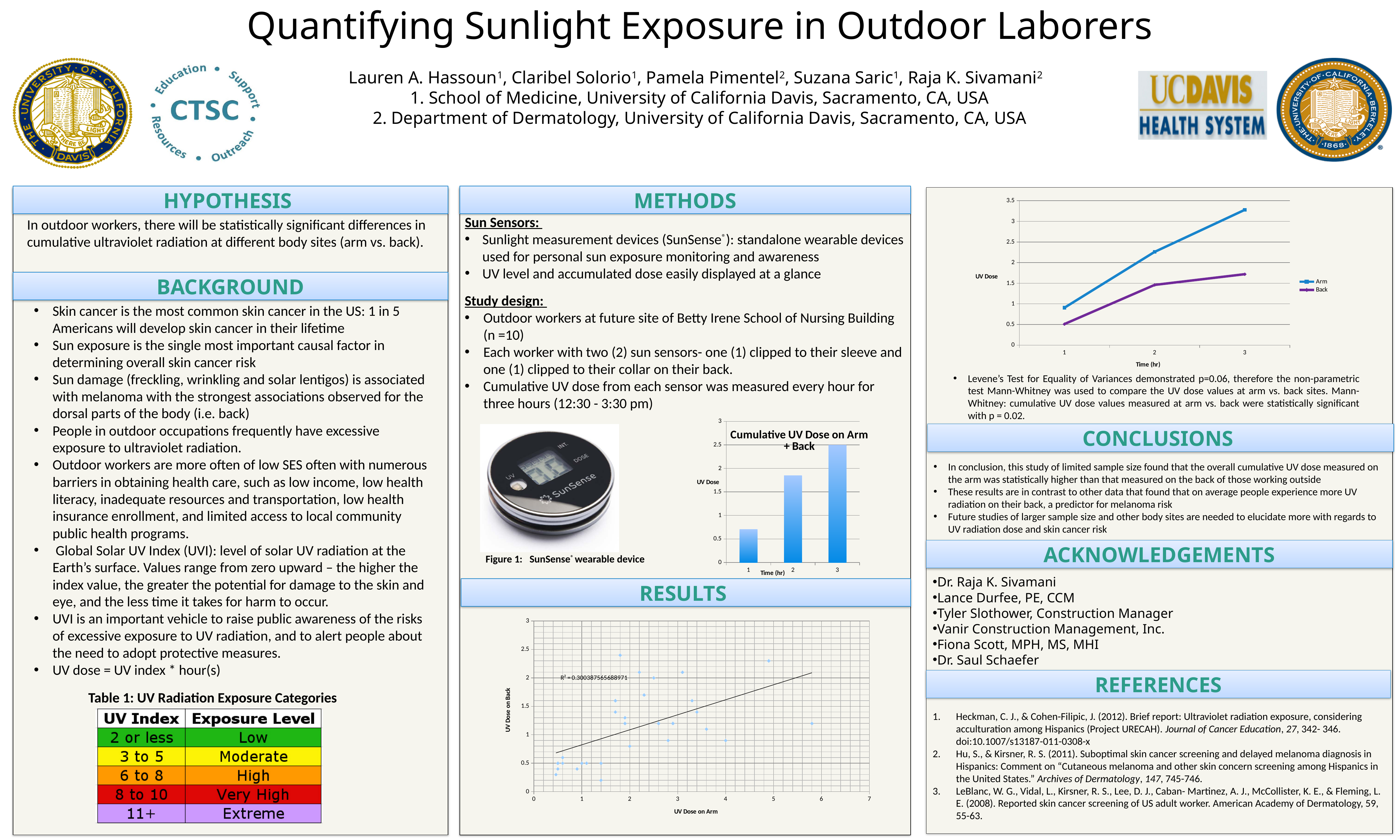
In the top-right line chart, which series has the higher value at 3 hours, Arm or Back? Arm What type of chart is the chart in the top-right panel showing UV Dose against Time (hr)? line chart In the top-right line chart, is the Back value at 1 hour greater or less than 1? less In the 'Cumulative UV Dose on Arm + Back' chart, is the bar for hour 1 greater or less than 1? less In the 'Cumulative UV Dose on Arm + Back' chart, which time (hr) has the highest bar? 3 How many series does the legend of the top-right line chart list? 2 What type of chart is the 'Cumulative UV Dose on Arm + Back' chart? bar chart In the top-right line chart, is the Arm value at 3 hours greater or less than 3? greater In the top-right line chart, do the Arm values rise or fall as time increases from 1 to 3 hours? rise How many bars are shown in the 'Cumulative UV Dose on Arm + Back' chart? 3 What R² value is printed on the scatter plot in the Results section? R² = 0.300387565688971 What is the x-axis label of the scatter plot in the Results section? UV Dose on Arm